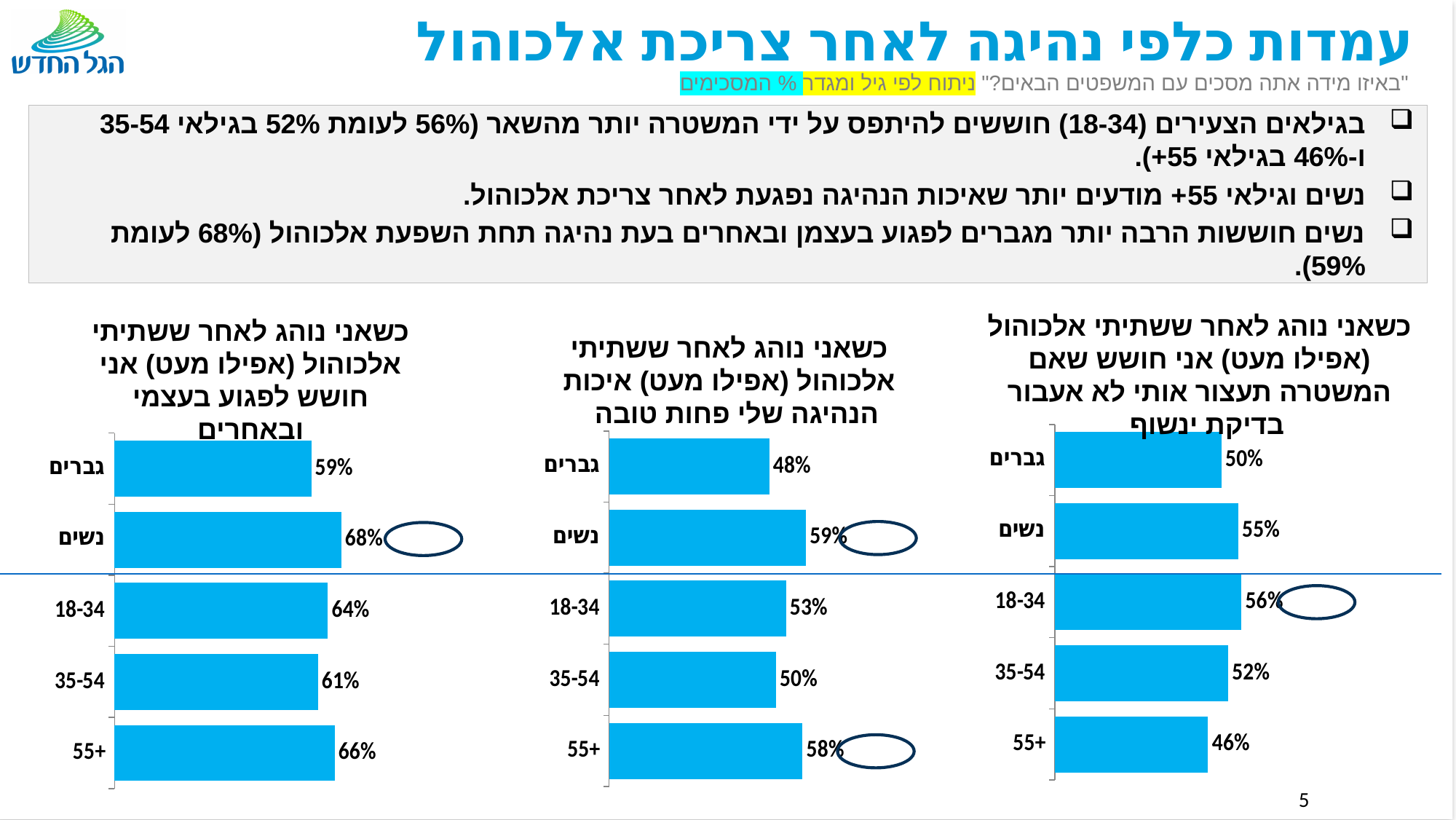
In the right chart (fear of failing a breathalyzer test), which is larger: the value for 18-34 or the value for 35-54? 18-34 In the right chart (fear of failing a breathalyzer test), do the values rise or fall across the age groups from 18-34 to 55+? fall How many bar charts are shown on the slide? 3 How many categories are shown in the left chart (fear of hurting myself and others)? 5 In the left chart (fear of hurting myself and others), what is the value for נשים? 68% In the left chart (fear of hurting myself and others), what is the difference between the values for נשים and גברים? 9% In the middle chart (driving quality is worse), what is the value for גברים? 48% In the middle chart (driving quality is worse), which category has the lowest value? גברים In the right chart (fear of failing a breathalyzer test), what is the value for 55+? 46% In the right chart (fear of failing a breathalyzer test), which category has the highest value? 18-34 What kind of chart is the middle chart (driving quality is worse)? bar chart In the middle chart (driving quality is worse), what is the difference between the values for 55+ and 35-54? 8%